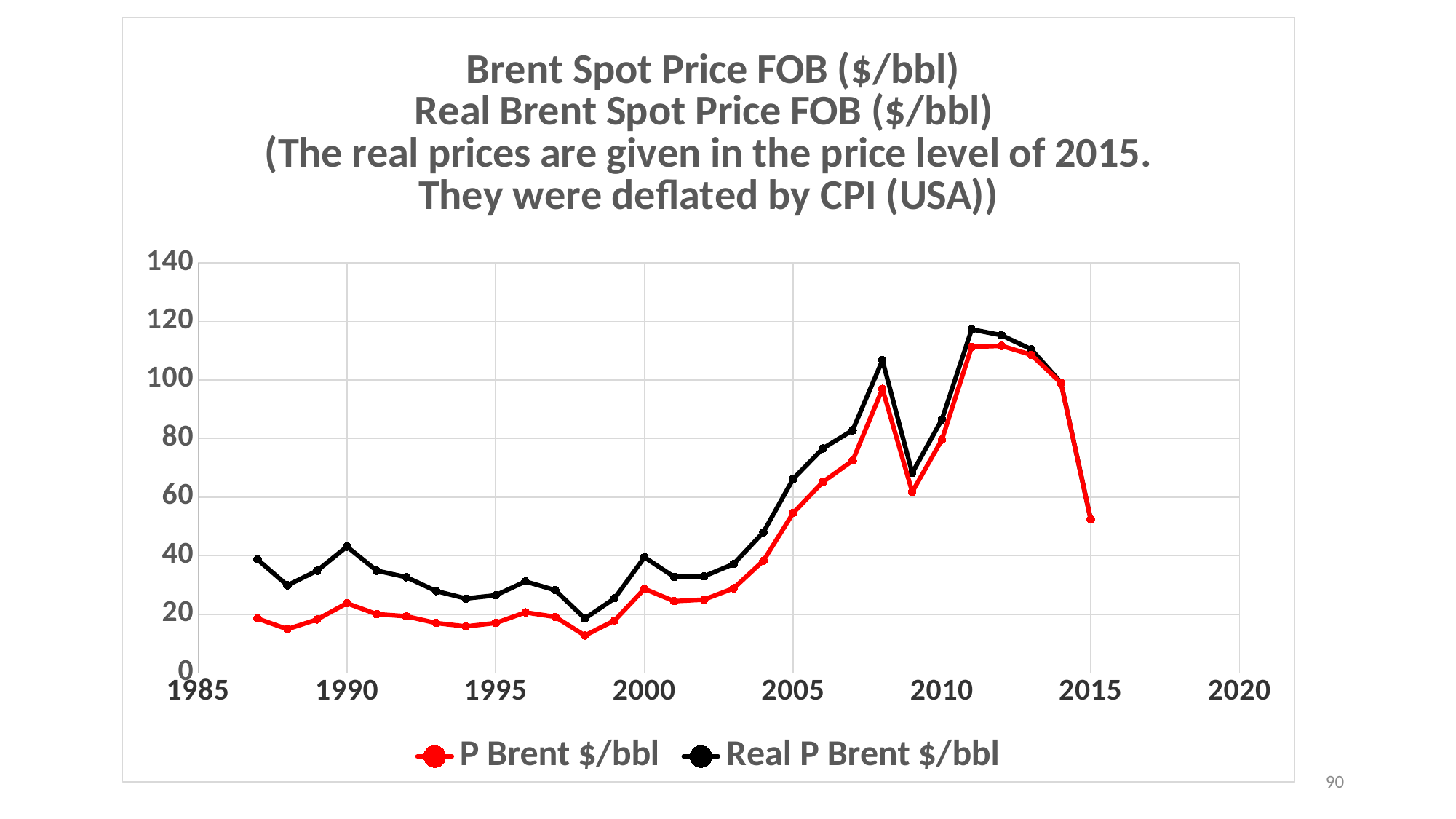
What kind of chart is shown on the slide? line chart In which year does the P Brent $/bbl series reach its lowest value? 1998 Is the value for P Brent $/bbl in 2009 greater or less than 80? less What colour is the line for Real P Brent $/bbl? black In 2008, which series has the higher value, P Brent $/bbl or Real P Brent $/bbl? Real P Brent $/bbl Does the P Brent $/bbl series rise or fall between 2012 and 2015? fall According to the title, in which year's price level are the real prices given? 2015 Is the value for P Brent $/bbl in 2015 greater or less than 60? less Is the value for P Brent $/bbl in 1998 greater or less than 20? less How many series does the legend list? 2 For P Brent $/bbl, which year has the larger value, 2008 or 2009? 2008